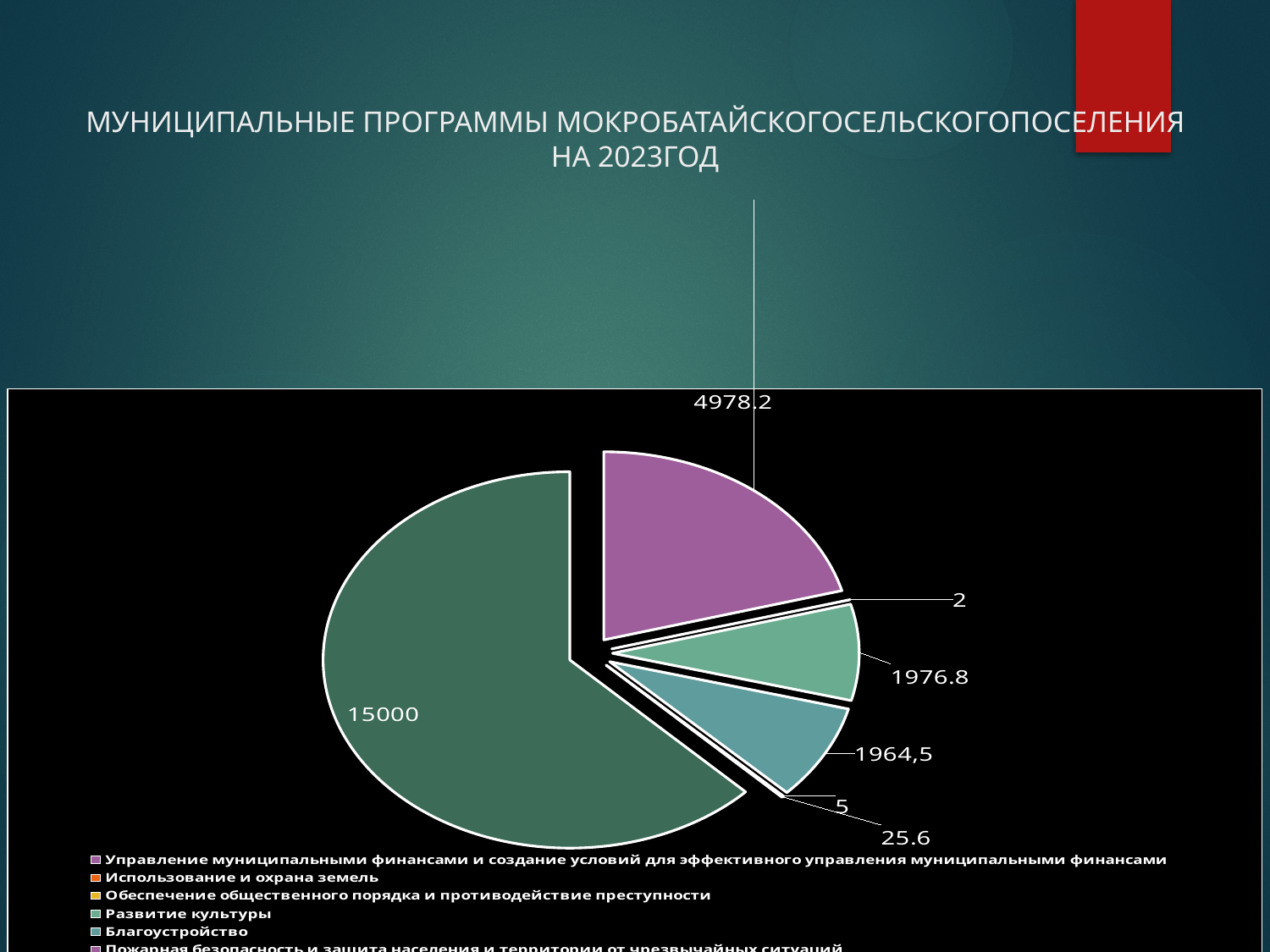
What is the title of the slide? МУНИЦИПАЛЬНЫЕ ПРОГРАММЫ МОКРОБАТАЙСКОГОСЕЛЬСКОГОПОСЕЛЕНИЯ НА 2023ГОД How many slices does the pie chart have? 7 Which slice has the larger value, 'Развитие культуры' or 'Благоустройство'? Развитие культуры What is the smallest value labelled on the pie chart? 2 What is the difference between the largest slice (15000) and the 'Управление муниципальными финансами' slice (4978.2)? 10021.8 What value is shown for the slice 'Управление муниципальными финансами и создание условий для эффективного управления муниципальными финансами'? 4978.2 What value is shown for the 'Развитие культуры' slice? 1976.8 What is the value of the largest slice in the pie chart? 15000 What value is shown for the 'Благоустройство' slice? 1964,5 What is the difference between the 'Управление муниципальными финансами' slice (4978.2) and the 'Развитие культуры' slice (1976.8)? 3001.4 What kind of chart is shown on the slide? pie chart What colour is the largest slice of the pie chart? dark green